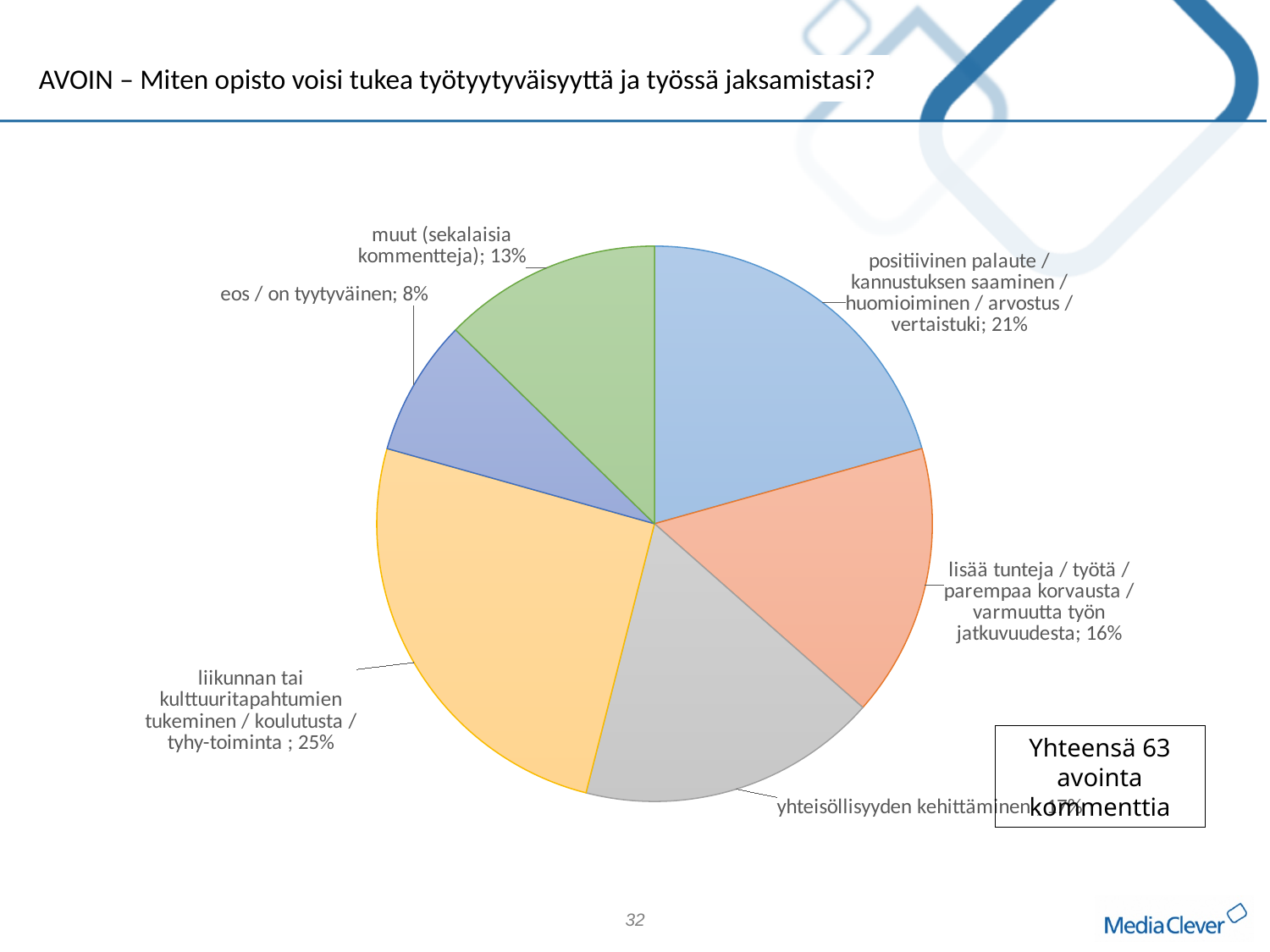
What percentage is shown for "eos / on tyytyväinen"? 8% What kind of chart is shown on the slide? pie chart What share of the pie is labelled "liikunnan tai kulttuuritapahtumien tukeminen / koulutusta / tyhy-toiminta"? 25% Which has a larger share: "lisää tunteja / työtä / parempaa korvausta / varmuutta työn jatkuvuudesta" or "muut (sekalaisia kommentteja)"? lisää tunteja / työtä / parempaa korvausta / varmuutta työn jatkuvuudesta How many slices does the pie chart have? 6 What percentage is shown for "muut (sekalaisia kommentteja)"? 13% According to the text box on the slide, how many open comments were there in total? 63 What percentage is shown for "positiivinen palaute / kannustuksen saaminen / huomioiminen / arvostus / vertaistuki"? 21% Which category has the smallest share of the pie? eos / on tyytyväinen What percentage is shown for "lisää tunteja / työtä / parempaa korvausta / varmuutta työn jatkuvuudesta"? 16% Which category has the largest share of the pie? liikunnan tai kulttuuritapahtumien tukeminen / koulutusta / tyhy-toiminta What is the difference in percentage points between "positiivinen palaute / kannustuksen saaminen / huomioiminen / arvostus / vertaistuki" and "muut (sekalaisia kommentteja)"? 8